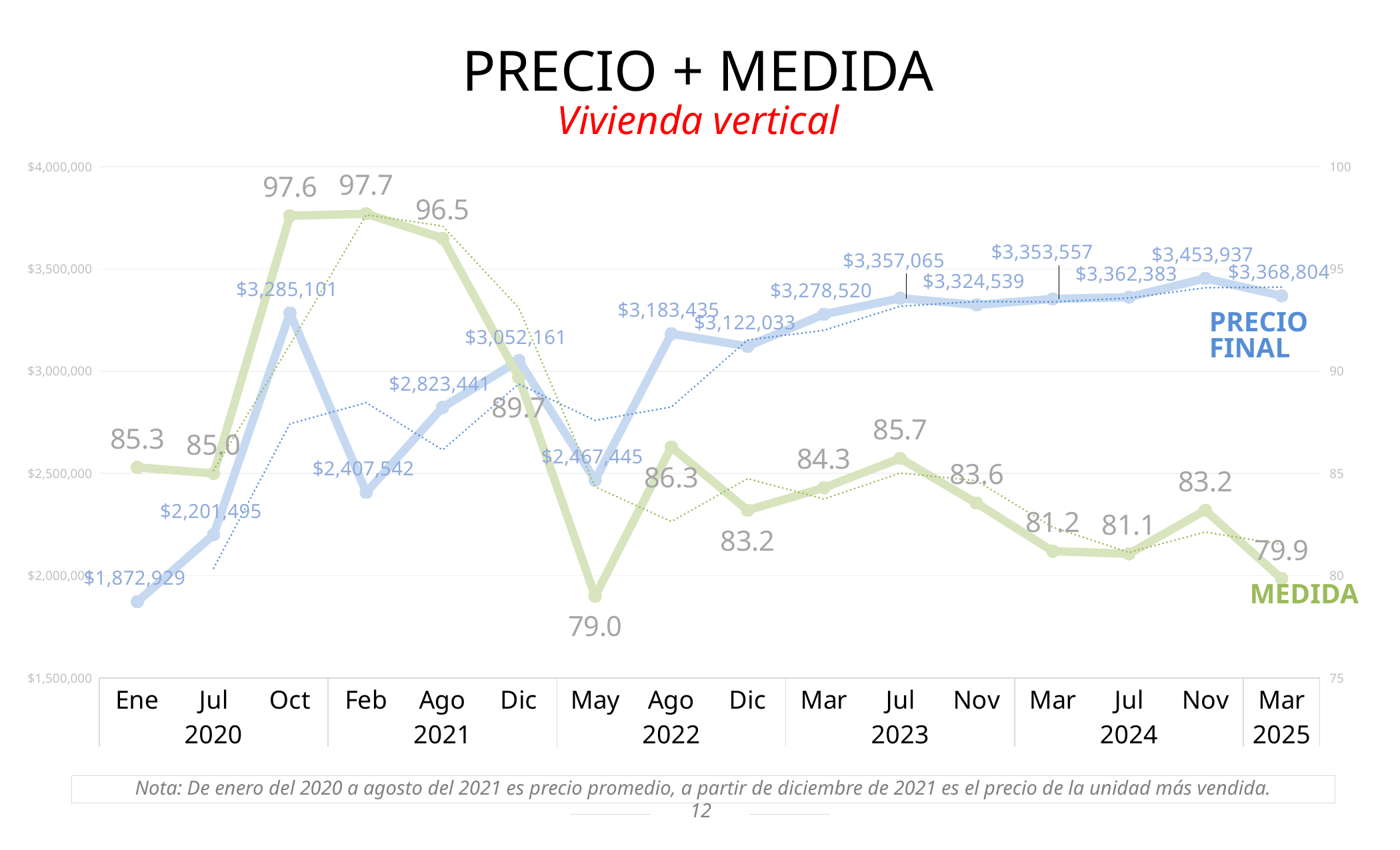
What kind of chart is shown on the slide? line chart What is the PRECIO FINAL value for Oct 2020? $3,285,101 How many series are labelled on the chart? 2 What is the difference between the PRECIO FINAL values for Nov 2024 and Mar 2025? $85,133 What is the MEDIDA value for May 2022? 79.0 In which month and year does PRECIO FINAL reach its highest value? Nov 2024 In which month and year is PRECIO FINAL at its lowest? Ene 2020 What is the difference between the highest MEDIDA value (Feb 2021) and the lowest (May 2022)? 18.7 How many data points does each series have along the x axis? 16 What is the PRECIO FINAL value for Mar 2025? $3,368,804 In which month and year is MEDIDA at its highest? Feb 2021 Which is larger, the PRECIO FINAL value for Feb 2021 or for Ago 2021? Ago 2021